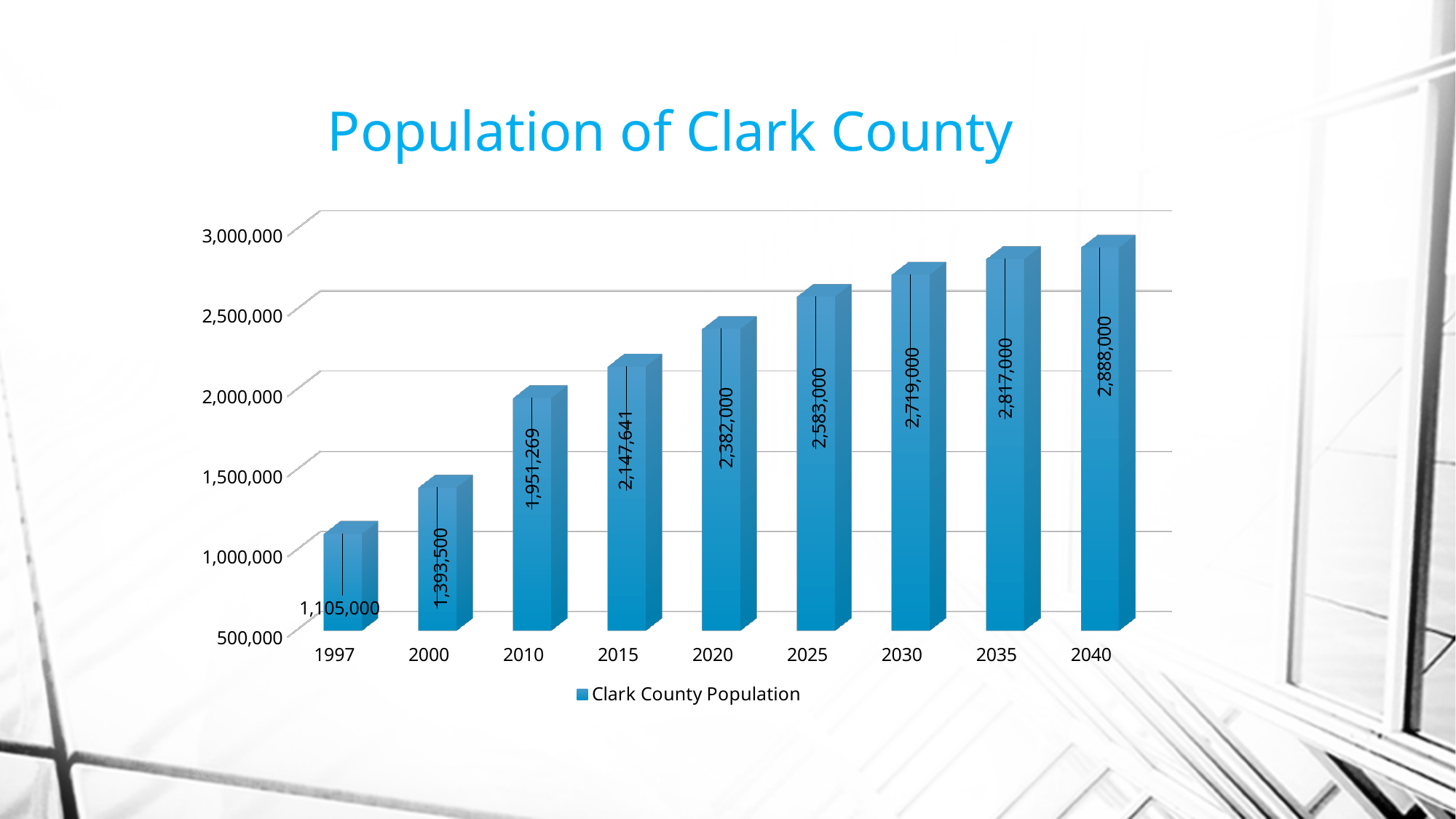
What is the difference between the population values for 2000 and 1997? 288,500 What is the Clark County population value shown for 2025? 2,583,000 Which year has the highest Clark County population on the chart? 2040 Do the population values rise or fall from 1997 to 2040? rise What kind of chart is shown on the slide? bar chart Which year has the lowest Clark County population on the chart? 1997 What is the difference between the population values for 2040 and 2035? 71,000 Is the population value for 2030 greater or less than 2,500,000? greater How many years are shown on the x axis of the chart? 9 Which is larger, the population value for 2015 or for 2020? 2020 What is the Clark County population value shown for 2010? 1,951,269 What is the Clark County population value shown for 1997? 1,105,000